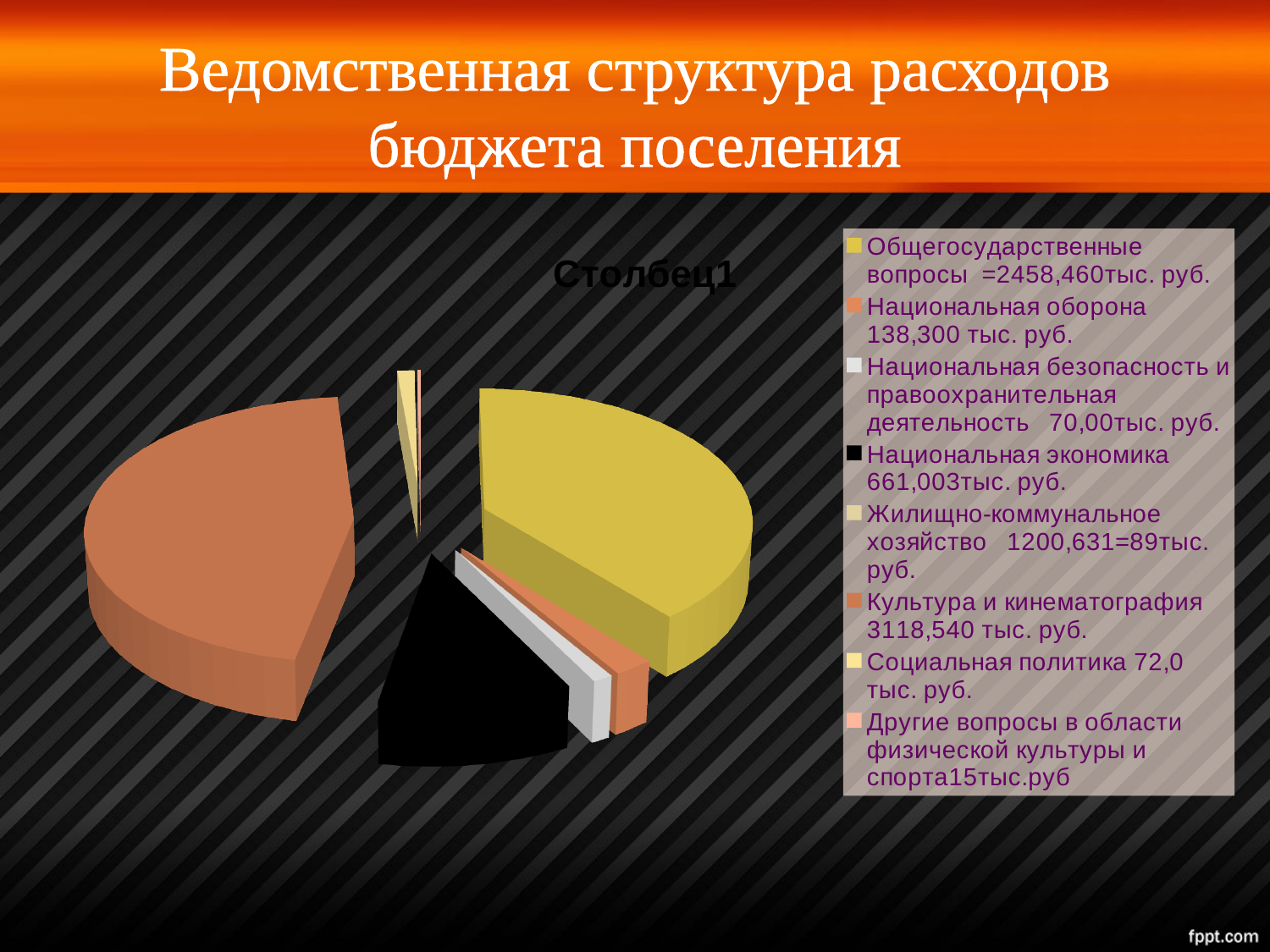
What kind of chart is shown on the slide? Pie chart What value is given in the legend for Общегосударственные вопросы? 2458,460 тыс. руб. What value is given in the legend for Социальная политика? 72,0 тыс. руб. What value is given in the legend for Национальная оборона? 138,300 тыс. руб. Which category has the smallest value in the pie chart? Другие вопросы в области физической культуры и спорта What is the difference between the values for Культура и кинематография and Общегосударственные вопросы? 660,080 тыс. руб. What value is given in the legend for Культура и кинематография? 3118,540 тыс. руб. Which category has the largest value in the pie chart? Культура и кинематография How many categories does the legend of the pie chart list? 8 What is the title shown above the pie chart? Столбец1 Which is larger: Общегосударственные вопросы or Национальная экономика? Общегосударственные вопросы What value is given in the legend for Национальная экономика? 661,003 тыс. руб.